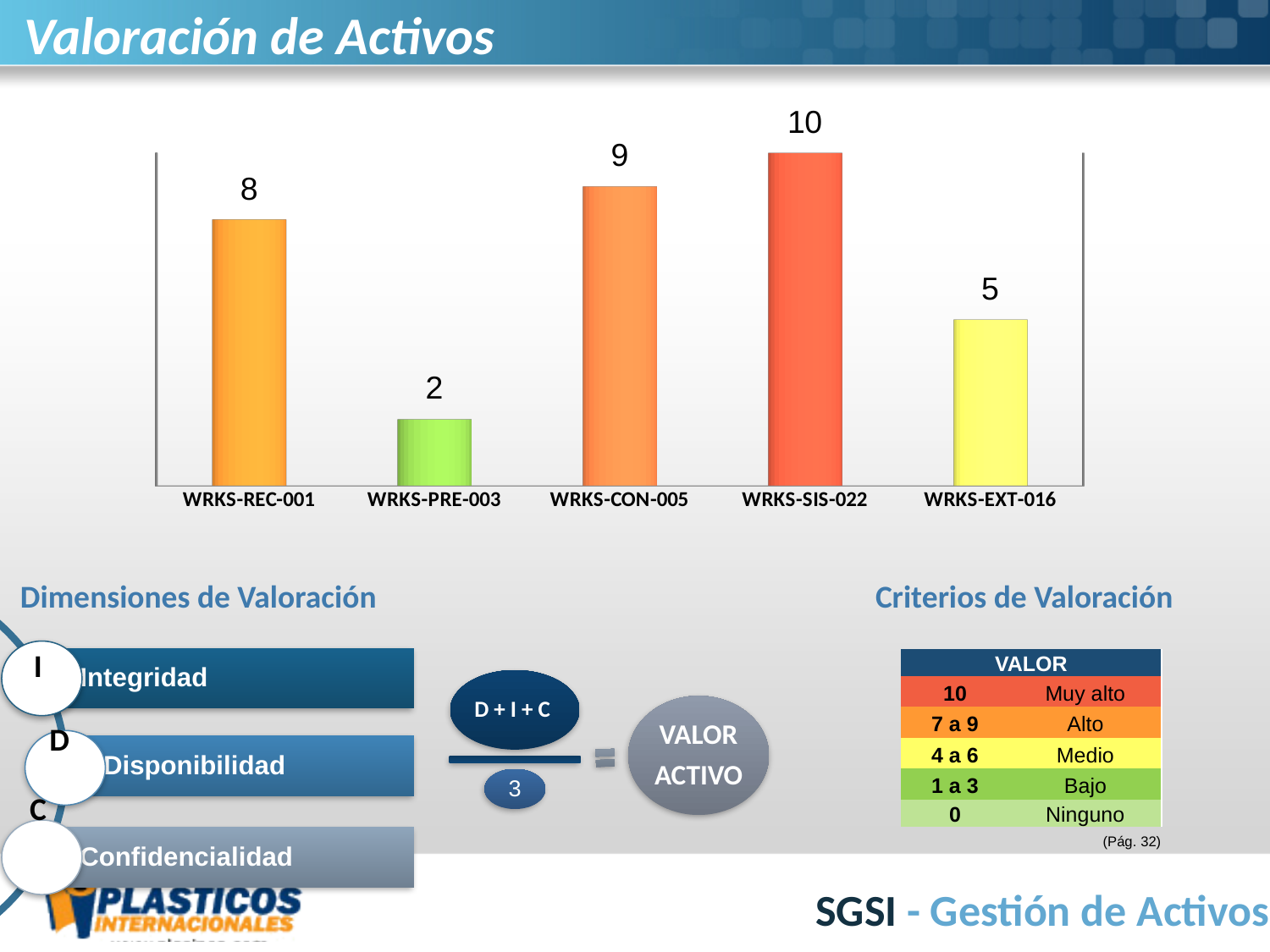
What is the value for WRKS-EXT-016? 5 Which category has the lowest value? WRKS-PRE-003 What kind of chart is shown on the slide? bar chart What is the value for WRKS-PRE-003? 2 What is the value for WRKS-CON-005? 9 Which category has the highest value? WRKS-SIS-022 What is the difference between the values for WRKS-SIS-022 and WRKS-PRE-003? 8 What colour is the bar for WRKS-PRE-003? green How many categories are shown in the chart? 5 Which is larger, the value for WRKS-CON-005 or the value for WRKS-EXT-016? WRKS-CON-005 What is the value for WRKS-REC-001? 8 What is the difference between the values for WRKS-REC-001 and WRKS-EXT-016? 3